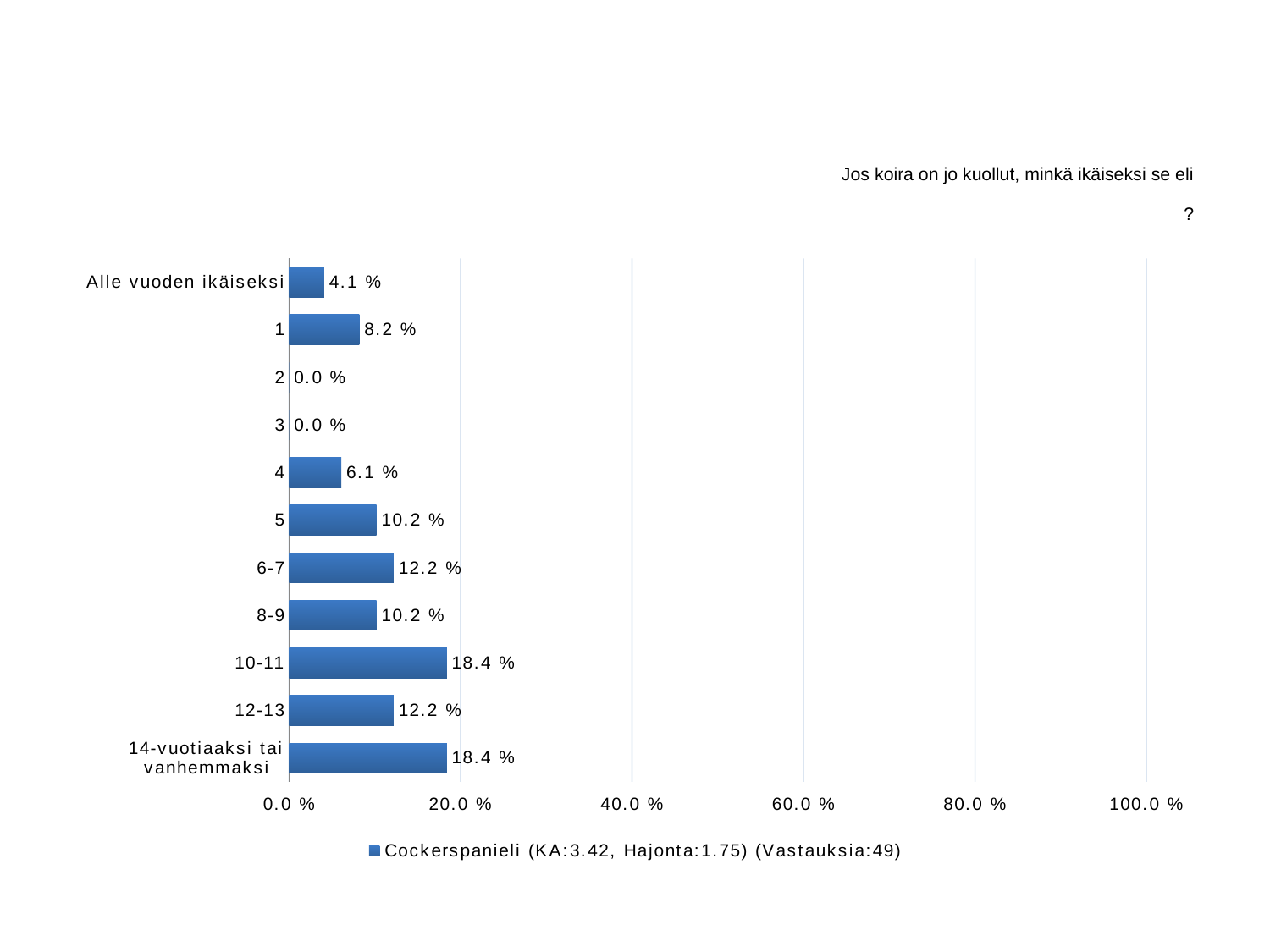
What is the value for the category "6-7"? 12.2 % What kind of chart is shown on the slide? bar chart What is the value for the category "Alle vuoden ikäiseksi"? 4.1 % What is the value for the category "10-11"? 18.4 % How many categories are shown on the chart? 11 What series name does the legend show? Cockerspanieli (KA:3.42, Hajonta:1.75) (Vastauksia:49) Which categories have a value of 0.0 %? 2 and 3 What is the difference between the values for "10-11" and "5"? 8.2 % Which two categories share the highest value on the chart? 10-11 and 14-vuotiaaksi tai vanhemmaksi Which is larger, the value for "1" or the value for "5"? 5 What is the value for the category "4"? 6.1 % Is the value for "14-vuotiaaksi tai vanhemmaksi" greater or less than 20.0 %? less